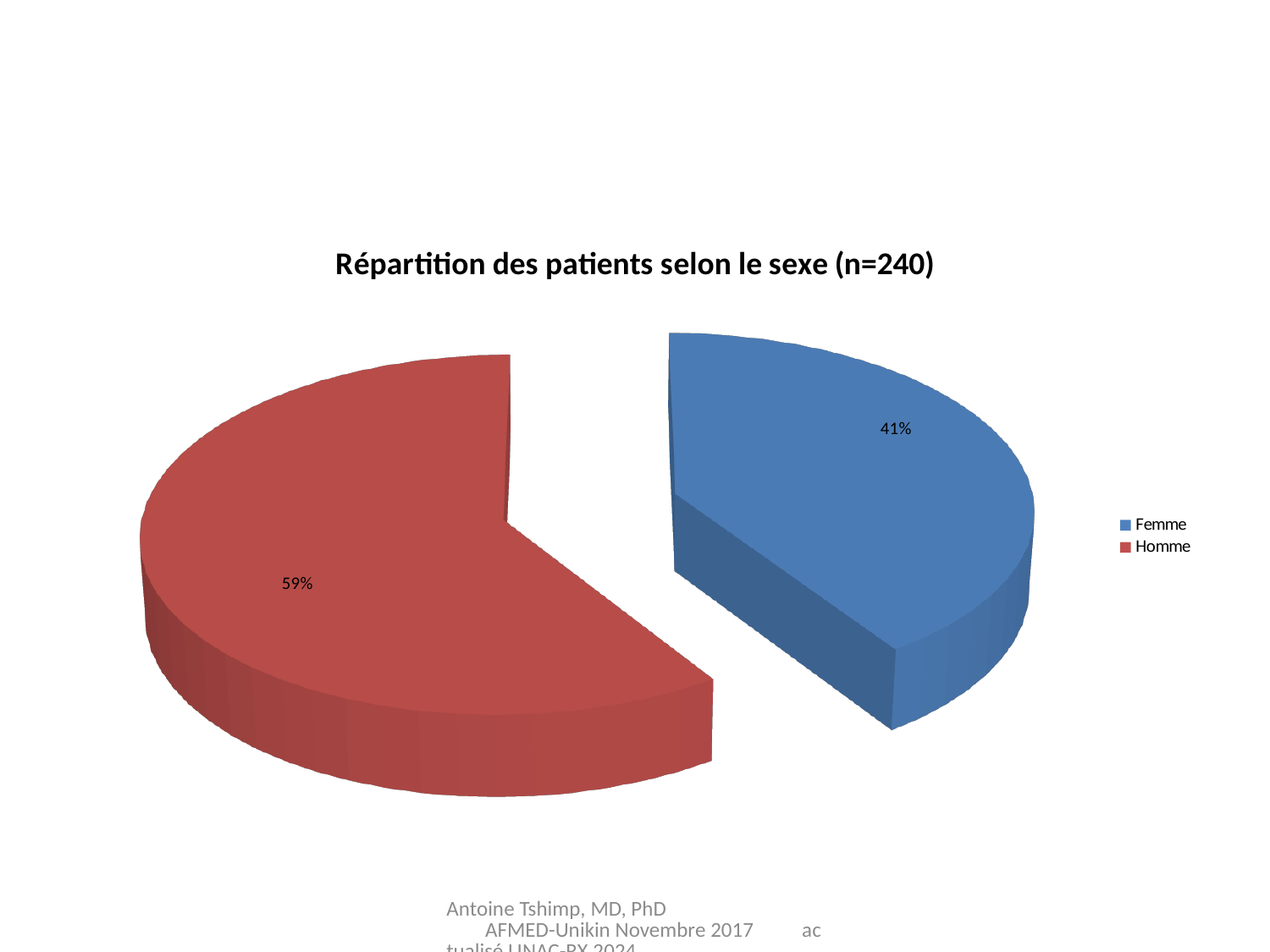
Which category has the largest share of the pie? Homme How many entries does the legend list? 2 What percentage of patients are Femme? 41% Which is larger, the share for Femme or the share for Homme? Homme Which category has the smallest share of the pie? Femme What is the title of the chart? Répartition des patients selon le sexe (n=240) What percentage of patients are Homme? 59% What kind of chart is shown on the slide? pie chart How many categories does the pie chart show? 2 What colour is the Homme slice? red What is the total number of patients stated in the chart title? 240 What is the difference in percentage points between the Homme and Femme shares? 18